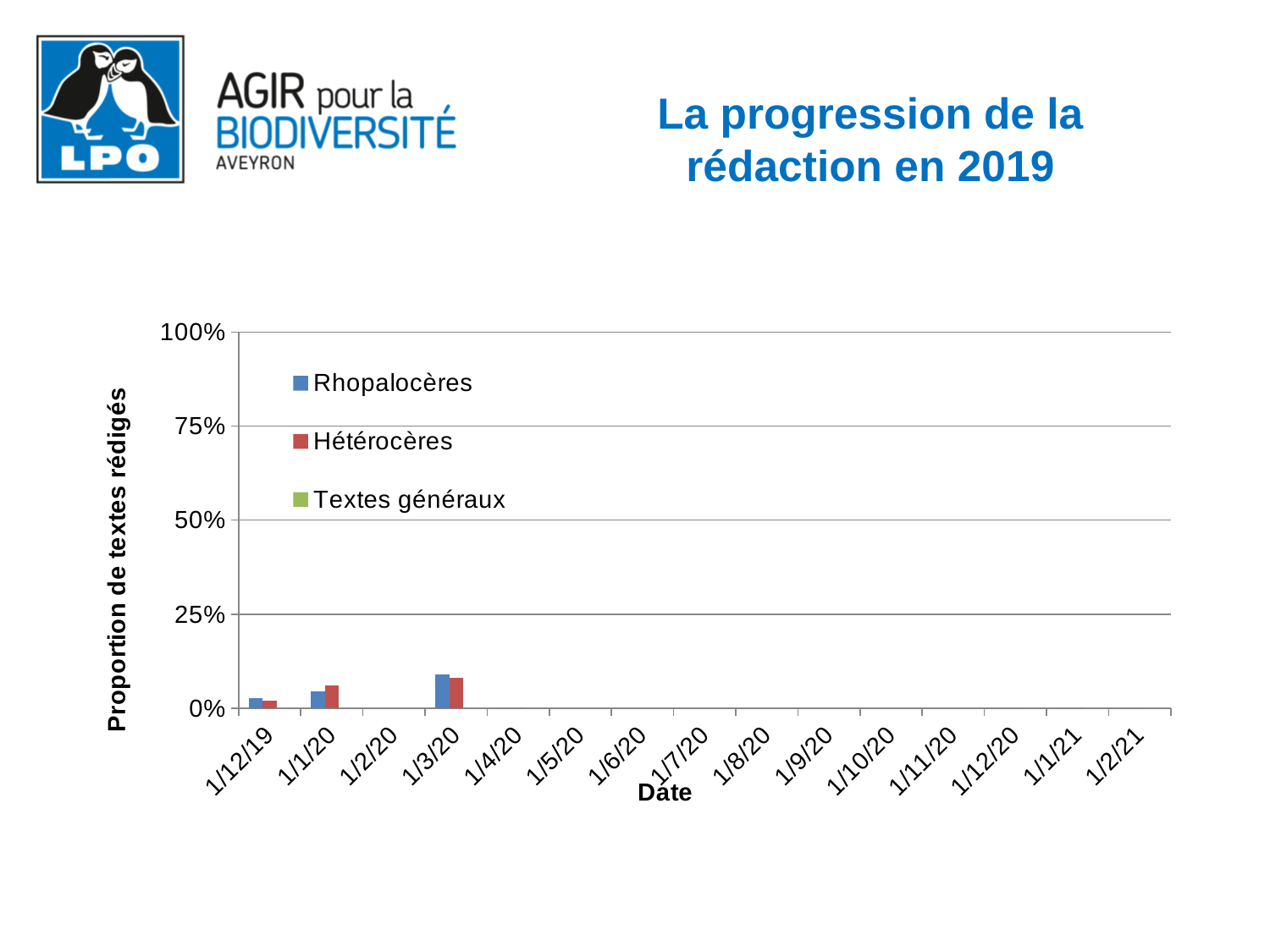
At which date does the Rhopalocères series reach its highest value? 1/3/20 How many date labels are shown along the x axis? 15 How many series does the legend list? 3 At 1/1/20, which series has the larger value, Rhopalocères or Hétérocères? Hétérocères Do the Rhopalocères values rise or fall from 1/12/19 to 1/3/20? rise At which date does the Hétérocères series reach its highest value? 1/3/20 Which series is shown in blue in the legend? Rhopalocères Is the value for Rhopalocères at 1/3/20 greater or less than 25%? less What is the title of the vertical axis? Proportion de textes rédigés Is the value for Hétérocères at 1/1/20 greater or less than 25%? less Is the value for Rhopalocères at 1/12/19 greater or less than 50%? less What kind of chart is shown on the slide? bar chart